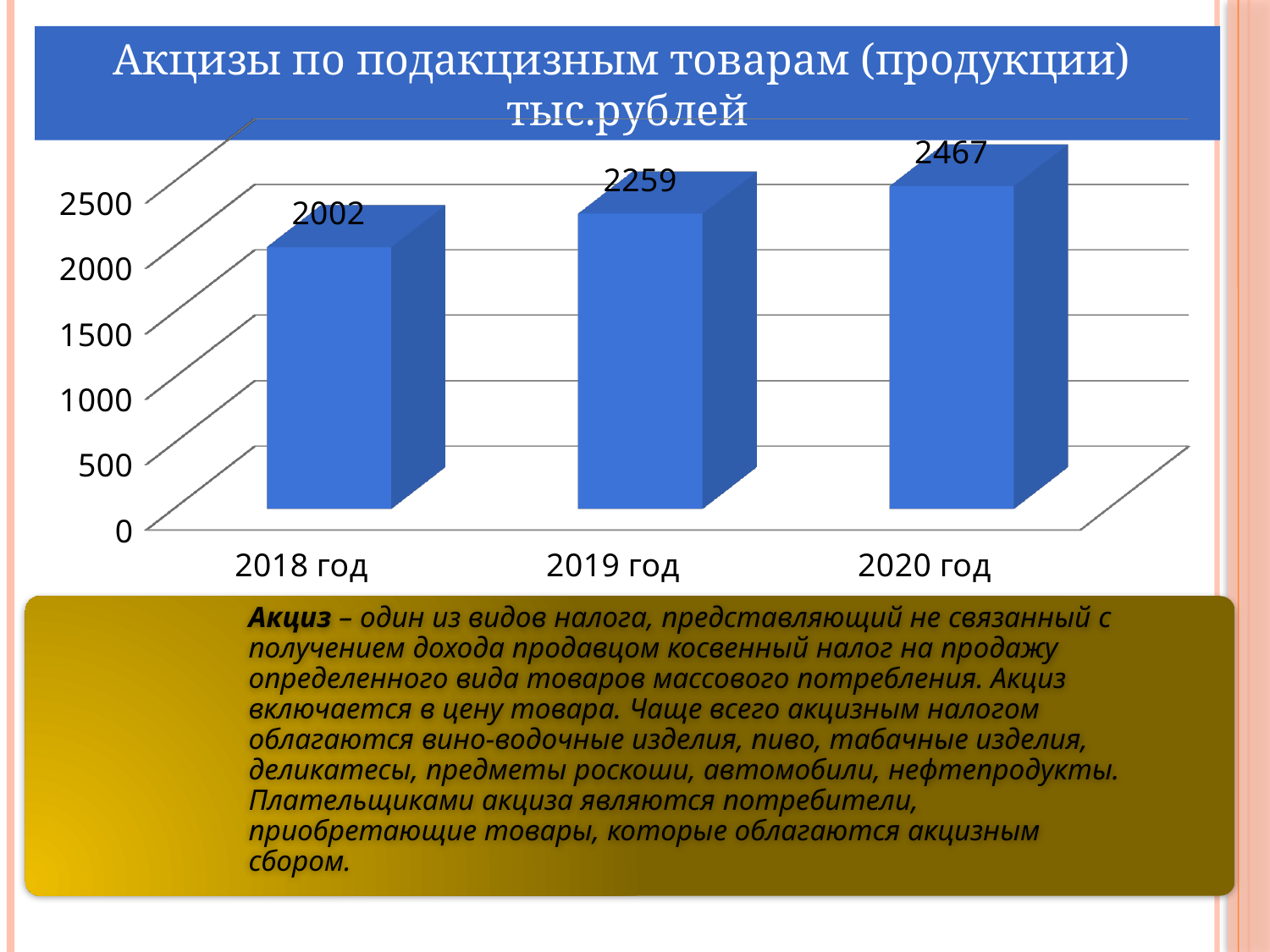
What kind of chart is shown on the slide? bar chart What is the value for 2019 год? 2259 What is the difference between the values for 2019 год and 2018 год? 257 Which is larger, the value for 2019 год or the value for 2020 год? 2020 год What is the difference between the values for 2020 год and 2018 год? 465 What is the value for 2018 год? 2002 What is the value for 2020 год? 2467 Is the value for 2018 год greater or less than 2500? less Which year has the highest value? 2020 год Which year has the lowest value? 2018 год Do the values rise or fall from 2018 год to 2020 год? rise How many years are shown on the chart? 3